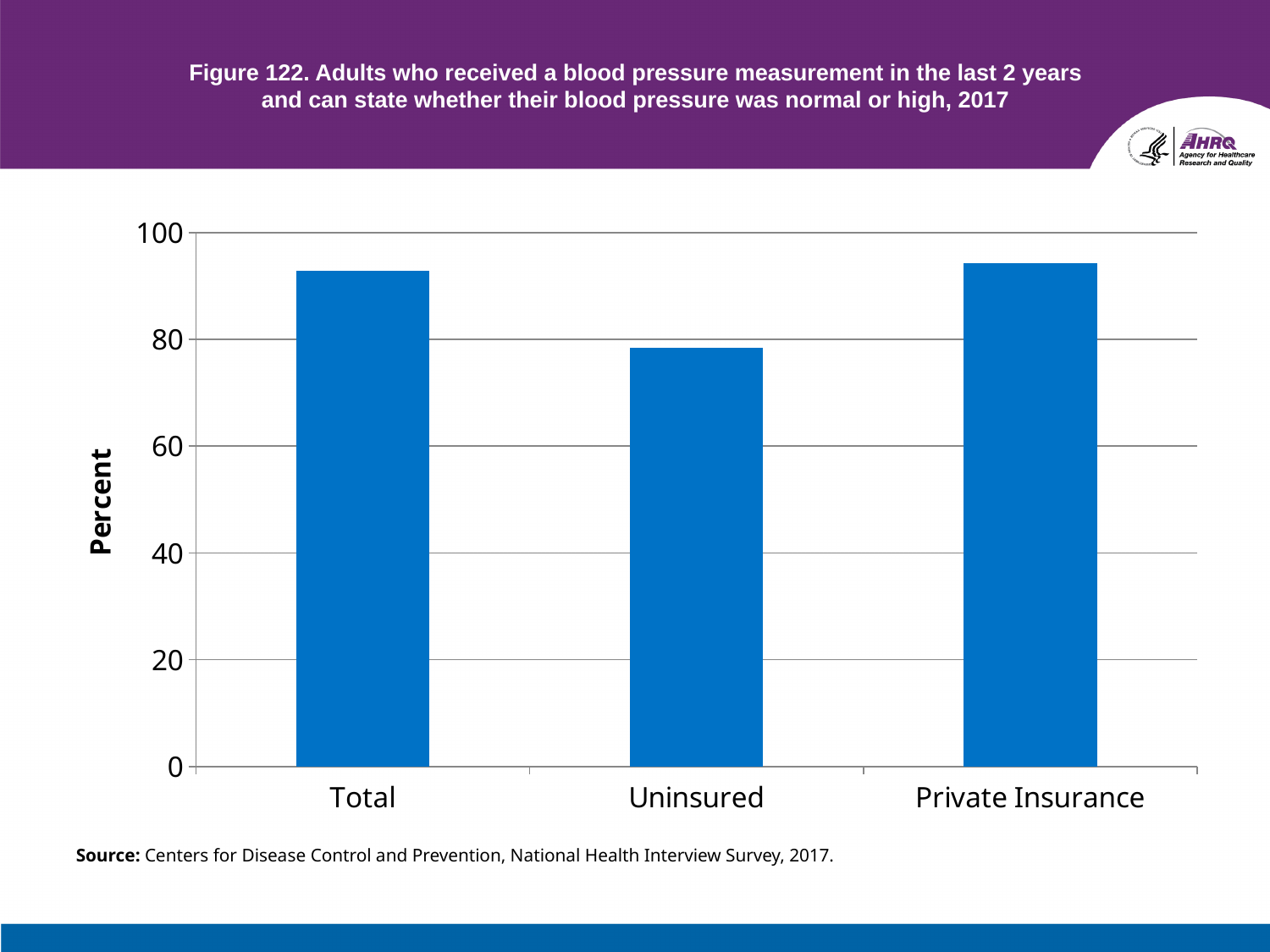
Is the value for Private Insurance greater or less than 80? greater What year does the chart's title say the data is for? 2017 Is the value for Uninsured greater or less than 60? greater Which is larger, the value for Total or the value for Uninsured? Total How many categories are shown on the x axis of the chart? 3 What is the label on the y axis of the chart? Percent Which category has the lowest value in the chart? Uninsured Is the value for Uninsured greater or less than 100? less What kind of chart is shown on the slide? bar chart Which is larger, the value for Uninsured or the value for Private Insurance? Private Insurance